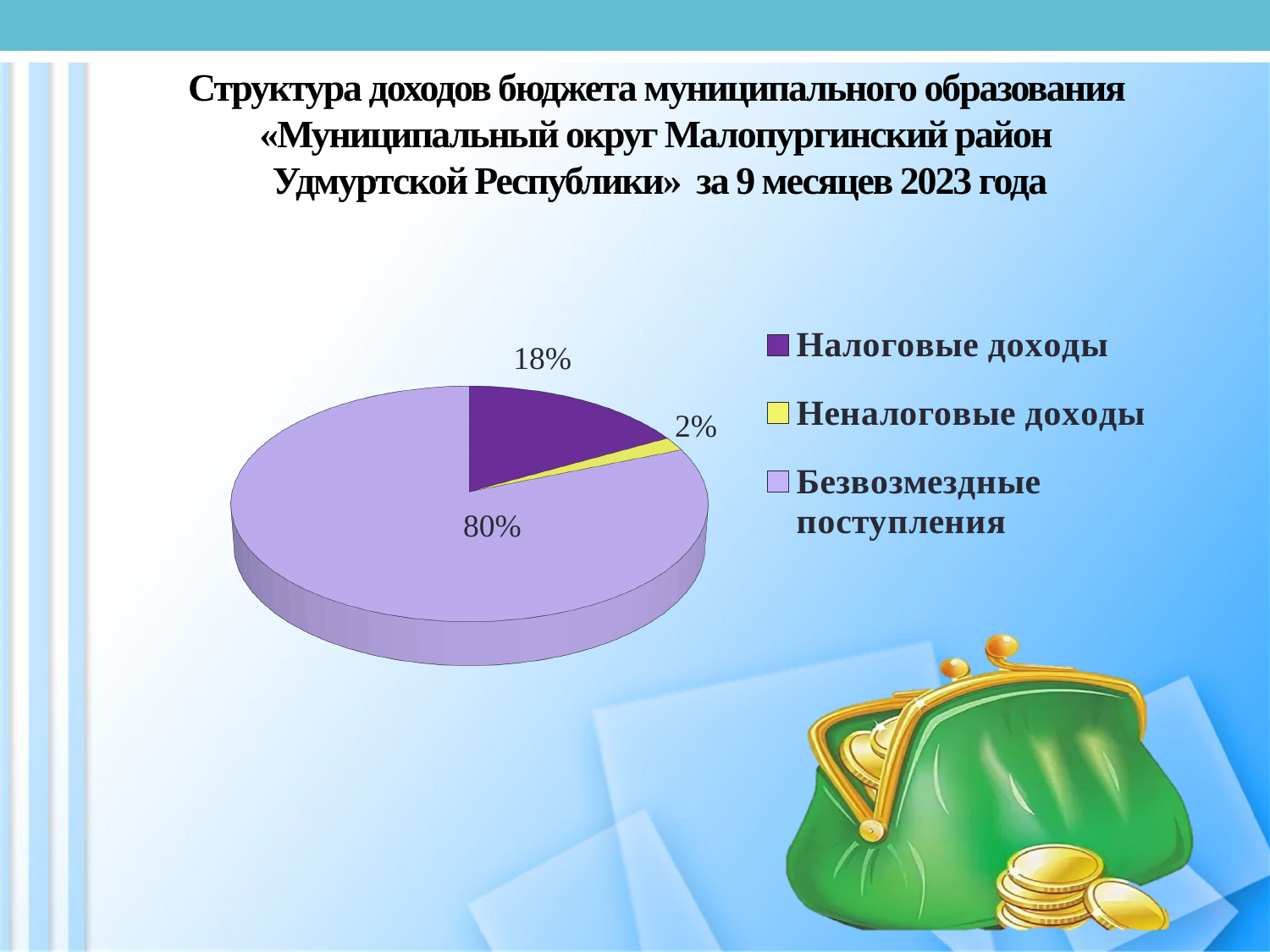
What is the difference in percentage points between Безвозмездные поступления and Налоговые доходы? 62 What share of the pie does Безвозмездные поступления have? 80% What kind of chart is shown on the slide? Pie chart Which is larger, Налоговые доходы or Неналоговые доходы? Налоговые доходы What is the difference in percentage points between Налоговые доходы and Неналоговые доходы? 16 What share of the pie does Налоговые доходы have? 18% Which category is shown in yellow in the legend? Неналоговые доходы Which category has the smallest slice of the pie? Неналоговые доходы Which category has the largest slice of the pie? Безвозмездные поступления How many categories does the pie chart show? 3 What period does the chart title say the data covers? 9 месяцев 2023 года What share of the pie does Неналоговые доходы have? 2%